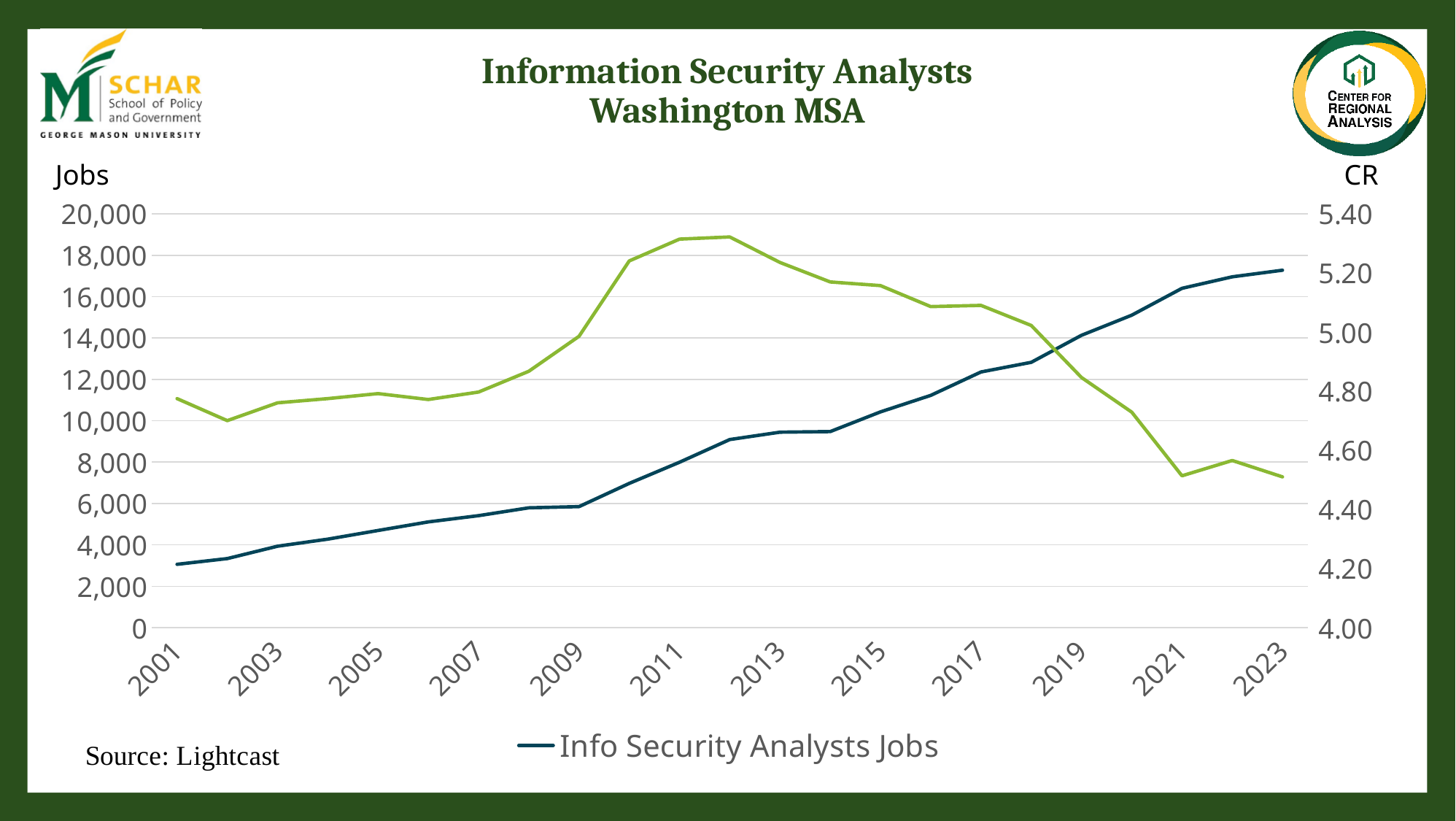
How many series does the legend list? 1 In which year is the Info Security Analysts Jobs value lowest? 2001 What is the title of the chart? Information Security Analysts Washington MSA What kind of chart is shown on the slide? line chart Is the Info Security Analysts Jobs value for 2023 greater or less than 16,000? greater Is the Info Security Analysts Jobs value for 2007 greater or less than 6,000? less Does the Info Security Analysts Jobs line rise or fall from 2001 to 2023? rise Which year has more Info Security Analysts Jobs, 2009 or 2019? 2019 In which year is the Info Security Analysts Jobs value highest? 2023 What is the label of the left vertical axis? Jobs Is the Info Security Analysts Jobs value for 2013 greater or less than 8,000? greater